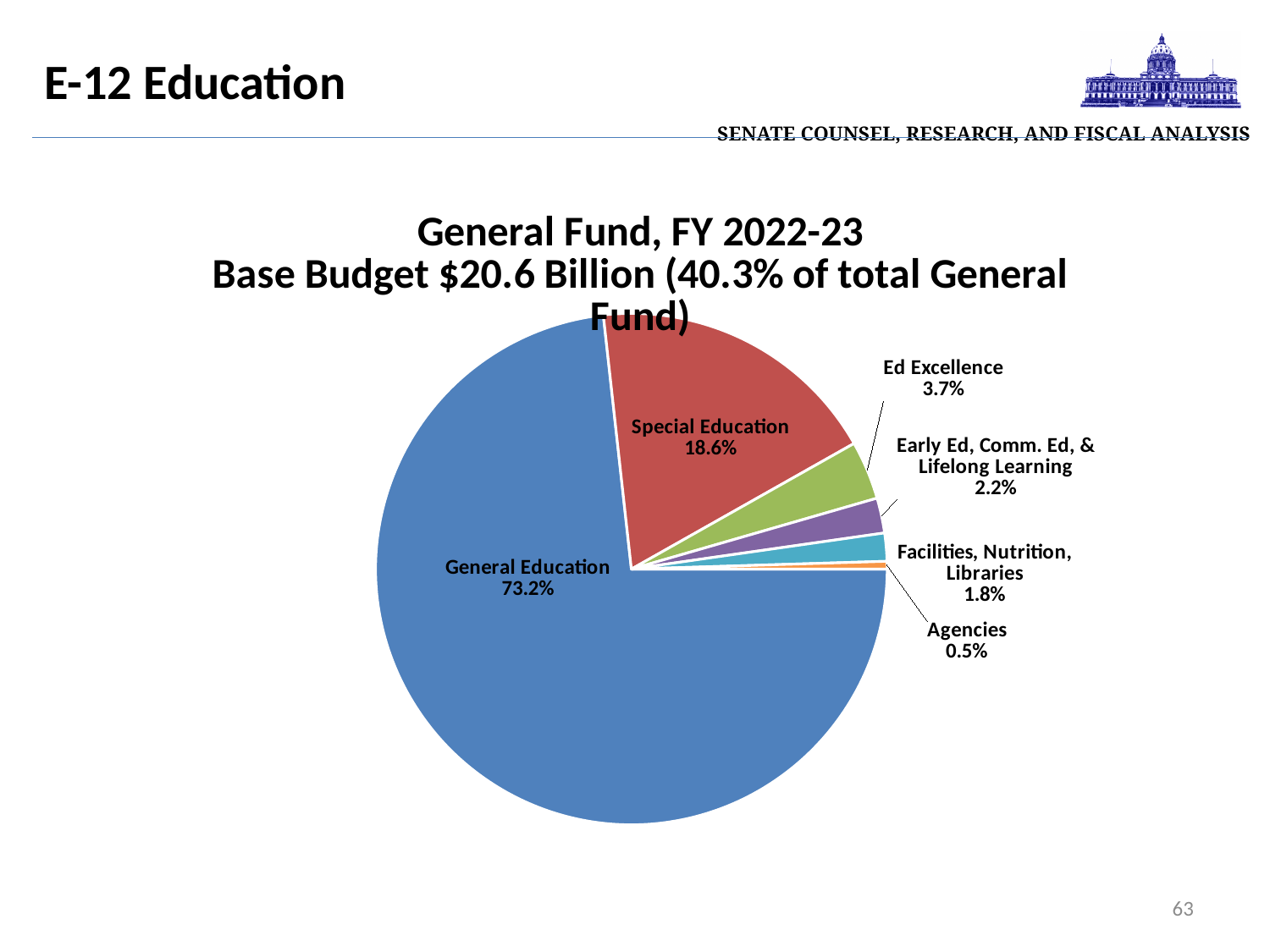
Which is larger, Ed Excellence or Facilities, Nutrition, Libraries? Ed Excellence What type of chart is shown on the slide? Pie chart What is the value shown for Ed Excellence? 3.7% Which category has the smallest slice of the pie? Agencies What is the value shown for Agencies? 0.5% What is the title of the chart? General Fund, FY 2022-23 Base Budget $20.6 Billion (40.3% of total General Fund) What is the value shown for Early Ed, Comm. Ed, & Lifelong Learning? 2.2% What share of the pie does Special Education represent? 18.6% What is the difference in percentage points between General Education and Special Education? 54.6 Which category has the largest slice of the pie? General Education What share of the pie does General Education represent? 73.2% How many slices does the pie chart have? 6